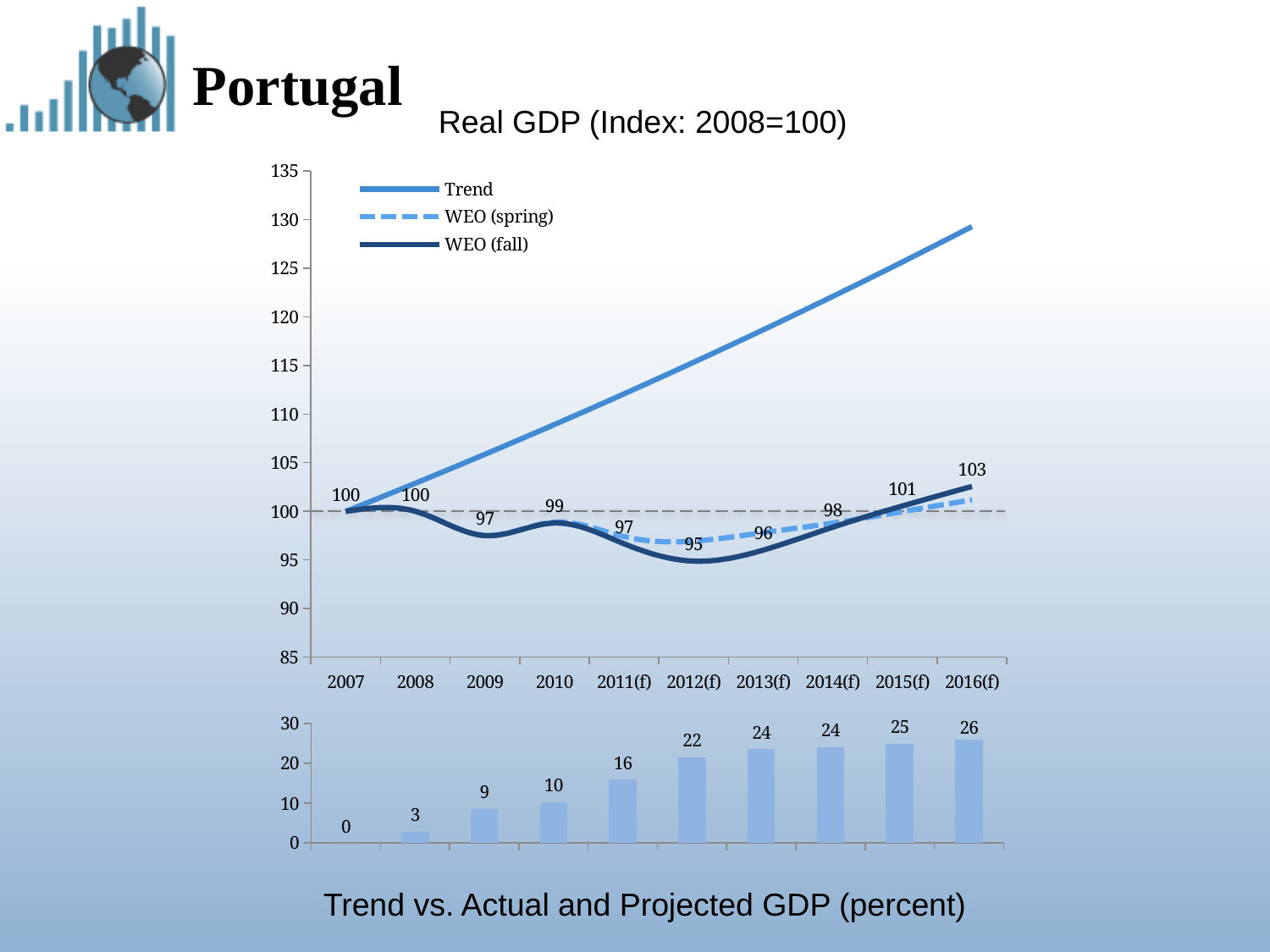
In the bottom 'Trend vs. Actual and Projected GDP (percent)' chart, which year has the lowest value? 2007 What kind of chart is the bottom chart titled 'Trend vs. Actual and Projected GDP (percent)'? bar chart How many series does the legend of the top 'Real GDP (Index: 2008=100)' chart list? 3 In the bottom 'Trend vs. Actual and Projected GDP (percent)' chart, what is the value for 2016(f)? 26 In the bottom 'Trend vs. Actual and Projected GDP (percent)' chart, what is the value for 2011(f)? 16 How many years are shown on the x axis of the bottom 'Trend vs. Actual and Projected GDP (percent)' chart? 10 In the bottom 'Trend vs. Actual and Projected GDP (percent)' chart, which year has the highest value? 2016(f) In the bottom 'Trend vs. Actual and Projected GDP (percent)' chart, do the values generally rise or fall from 2007 to 2016(f)? rise In the top 'Real GDP (Index: 2008=100)' chart, which series is higher at 2016(f): Trend or WEO (fall)? Trend In the top 'Real GDP (Index: 2008=100)' chart, is the Trend line value at 2016(f) greater or less than 125? greater In the top 'Real GDP (Index: 2008=100)' chart, what value is labelled at 2012(f)? 95 In the bottom 'Trend vs. Actual and Projected GDP (percent)' chart, what is the difference between the values for 2012(f) and 2009? 13